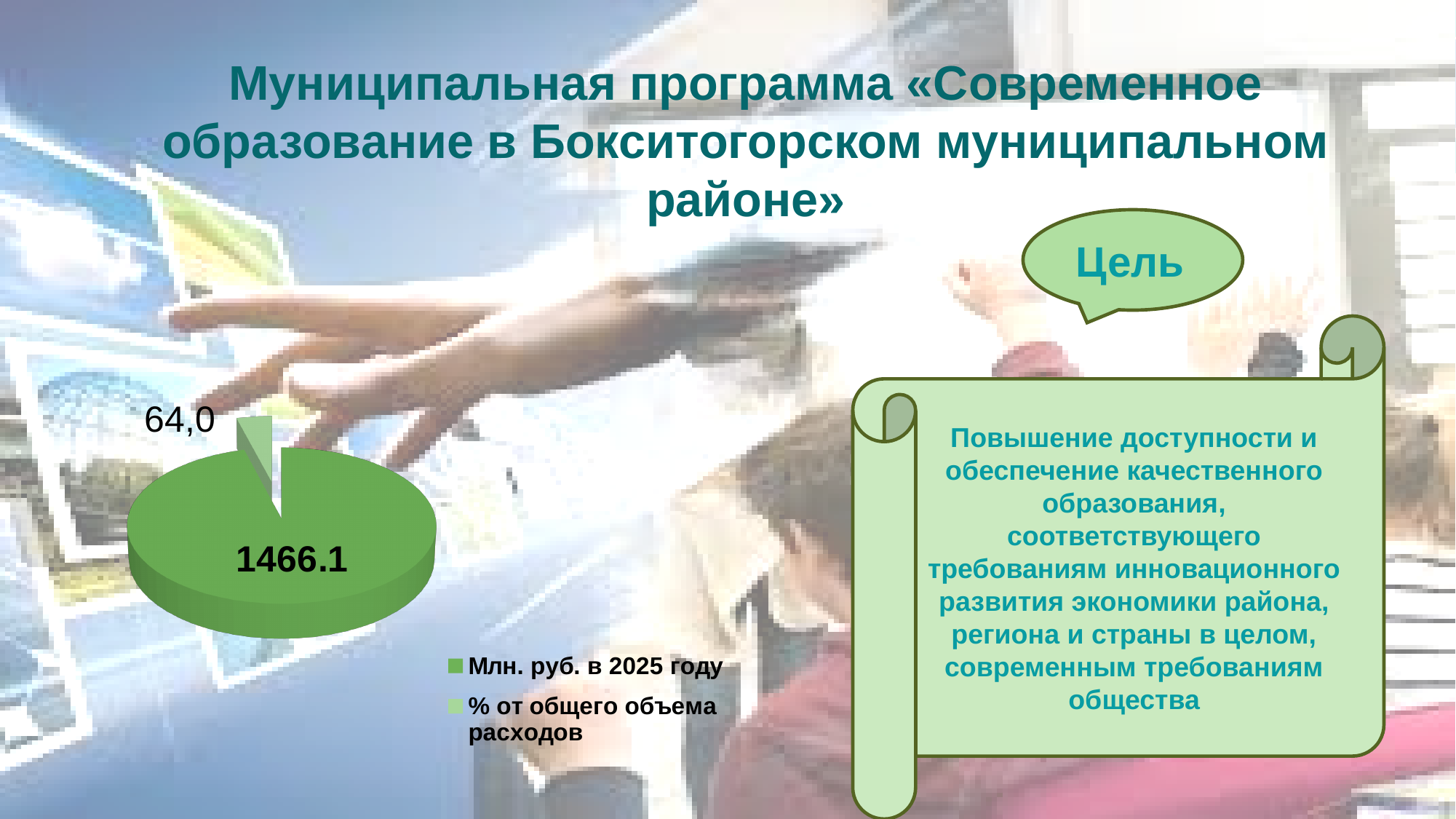
What value is printed for the slice "% от общего объема расходов"? 64,0 What is the second legend entry of the pie chart? % от общего объема расходов Which slice of the pie chart is the smallest? % от общего объема расходов Which slice is larger: "Млн. руб. в 2025 году" or "% от общего объема расходов"? Млн. руб. в 2025 году Is the value printed on the "Млн. руб. в 2025 году" slice greater or less than 1000? greater What value is printed on the slice labelled "Млн. руб. в 2025 году"? 1466.1 What colour is the slice for "Млн. руб. в 2025 году" in the pie chart? Dark green Which slice of the pie chart is the largest? Млн. руб. в 2025 году How many entries does the legend of the pie chart list? 2 How many slices does the pie chart have? 2 What kind of chart is shown on the slide? Pie chart